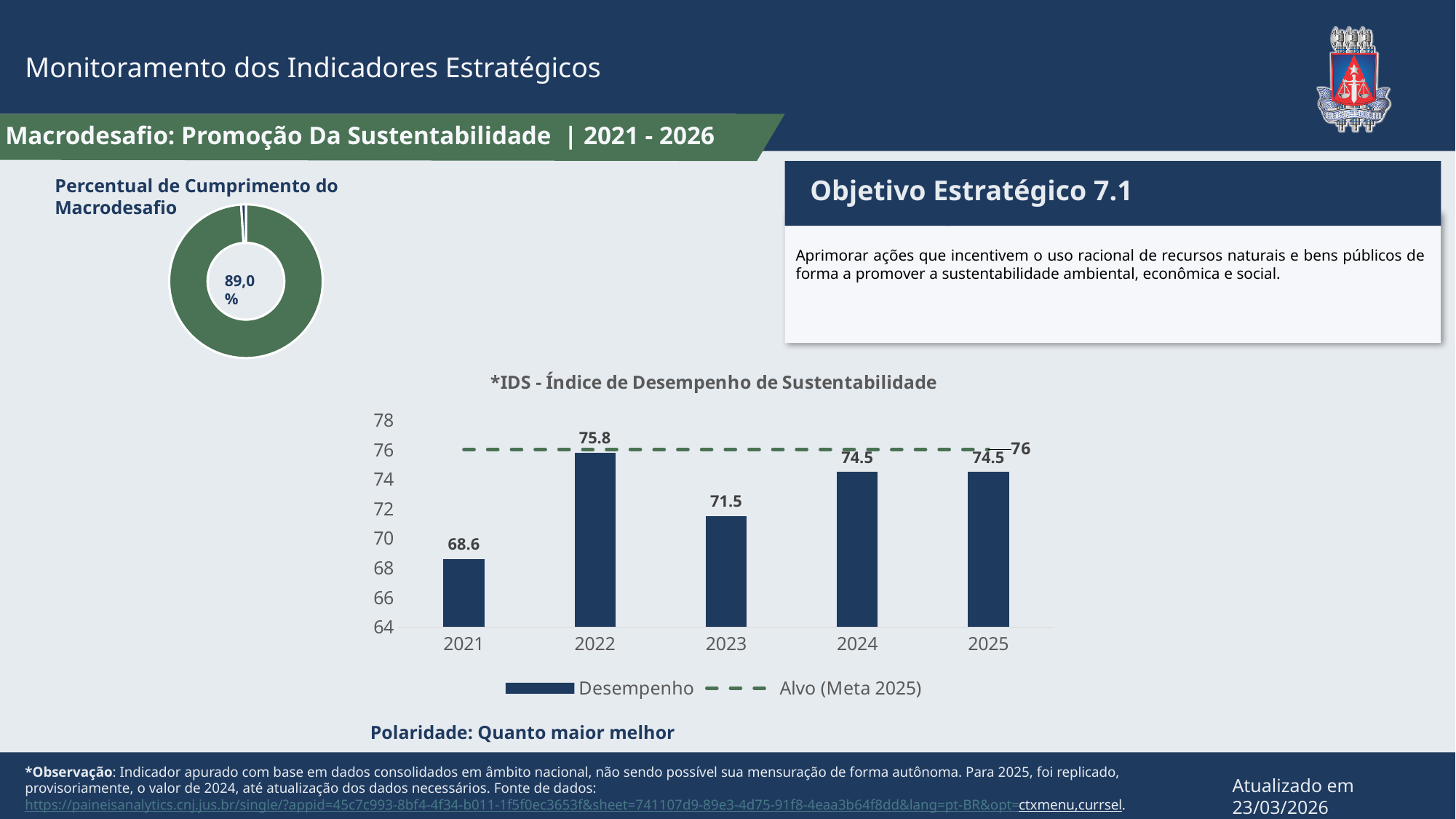
In the IDS - Índice de Desempenho de Sustentabilidade chart, what is the Desempenho value for 2022? 75.8 In the IDS - Índice de Desempenho de Sustentabilidade chart, what is the Desempenho value for 2021? 68.6 In the IDS - Índice de Desempenho de Sustentabilidade chart, what is the Desempenho value for 2023? 71.5 In the IDS - Índice de Desempenho de Sustentabilidade chart, how many series does the legend list? 2 In the IDS - Índice de Desempenho de Sustentabilidade chart, which year has the lowest Desempenho value? 2021 In the IDS - Índice de Desempenho de Sustentabilidade chart, which year has the highest Desempenho value? 2022 In the IDS - Índice de Desempenho de Sustentabilidade chart, how many years are shown on the x axis? 5 In the IDS - Índice de Desempenho de Sustentabilidade chart, what is the value of the Alvo (Meta 2025) line? 76 In the IDS - Índice de Desempenho de Sustentabilidade chart, is the Desempenho value for 2024 larger or smaller than the value for 2023? larger What kind of chart is the IDS - Índice de Desempenho de Sustentabilidade chart? Combination bar and line chart (bars for Desempenho with a dashed target line for Alvo) In the Percentual de Cumprimento do Macrodesafio donut chart, what percentage is shown in the centre? 89,0% In the IDS - Índice de Desempenho de Sustentabilidade chart, what is the difference between the 2022 value and the 2021 value? 7.2